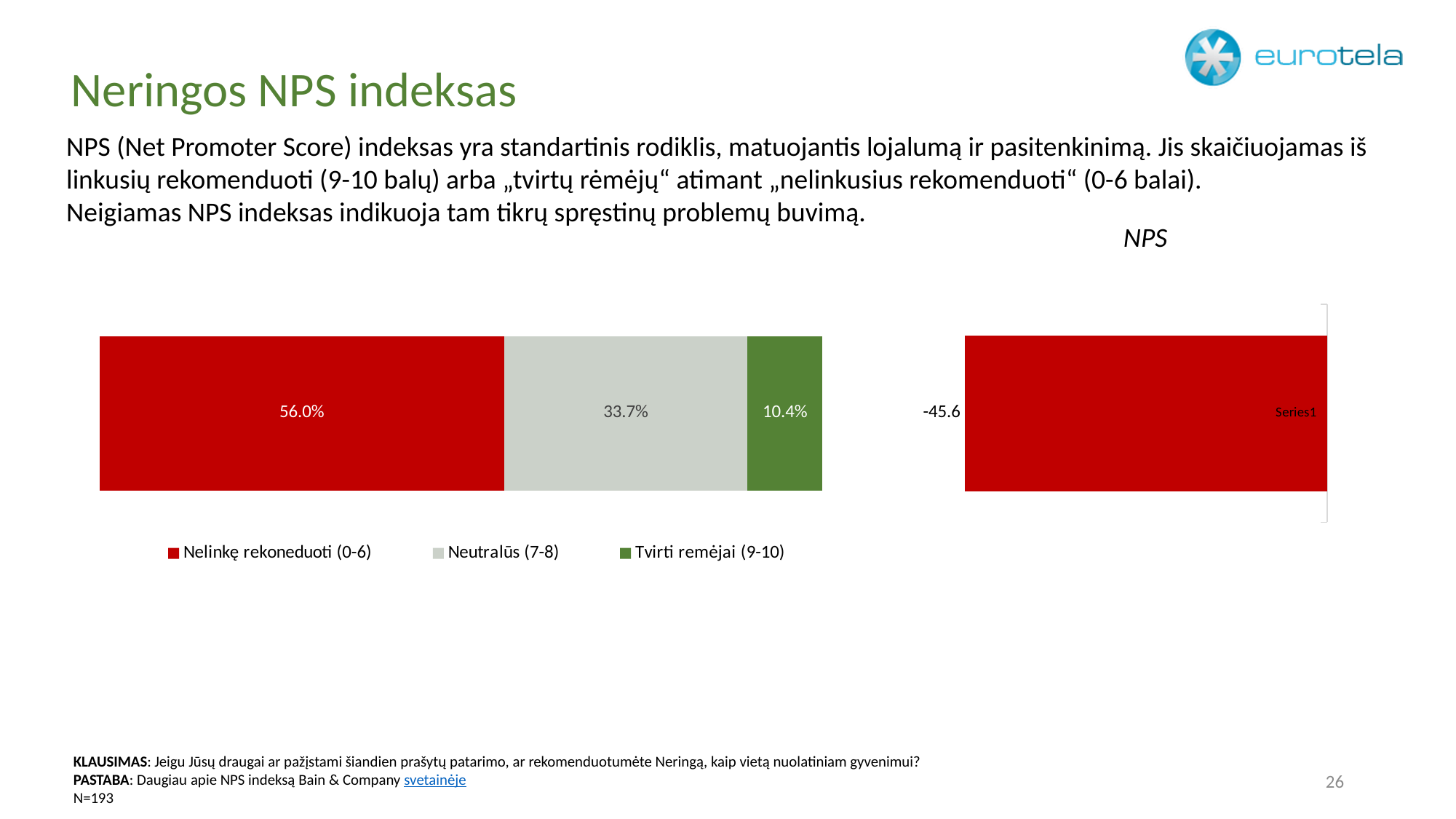
In the left stacked bar chart, which segment has the largest value? Nelinkę rekoneduoti (0-6) How many series does the legend of the left stacked bar chart list? 3 What is the title of the chart on the right side of the slide? NPS In the left stacked bar chart, what is the difference between Nelinkę rekoneduoti (0-6) and Tvirti remėjai (9-10)? 45.6% In the chart titled NPS on the right, what value is shown for the bar? -45.6 In the left stacked bar chart, what is the value for Neutralūs (7-8)? 33.7% In the left stacked bar chart, what is the value for Nelinkę rekoneduoti (0-6)? 56.0% What kind of chart is the left chart on the slide? Bar chart In the left stacked bar chart, what colour is the Tvirti remėjai (9-10) segment? Green In the left stacked bar chart, which segment has the smallest value? Tvirti remėjai (9-10) In the left stacked bar chart, which is larger: Neutralūs (7-8) or Tvirti remėjai (9-10)? Neutralūs (7-8) In the left stacked bar chart, what is the value for Tvirti remėjai (9-10)? 10.4%